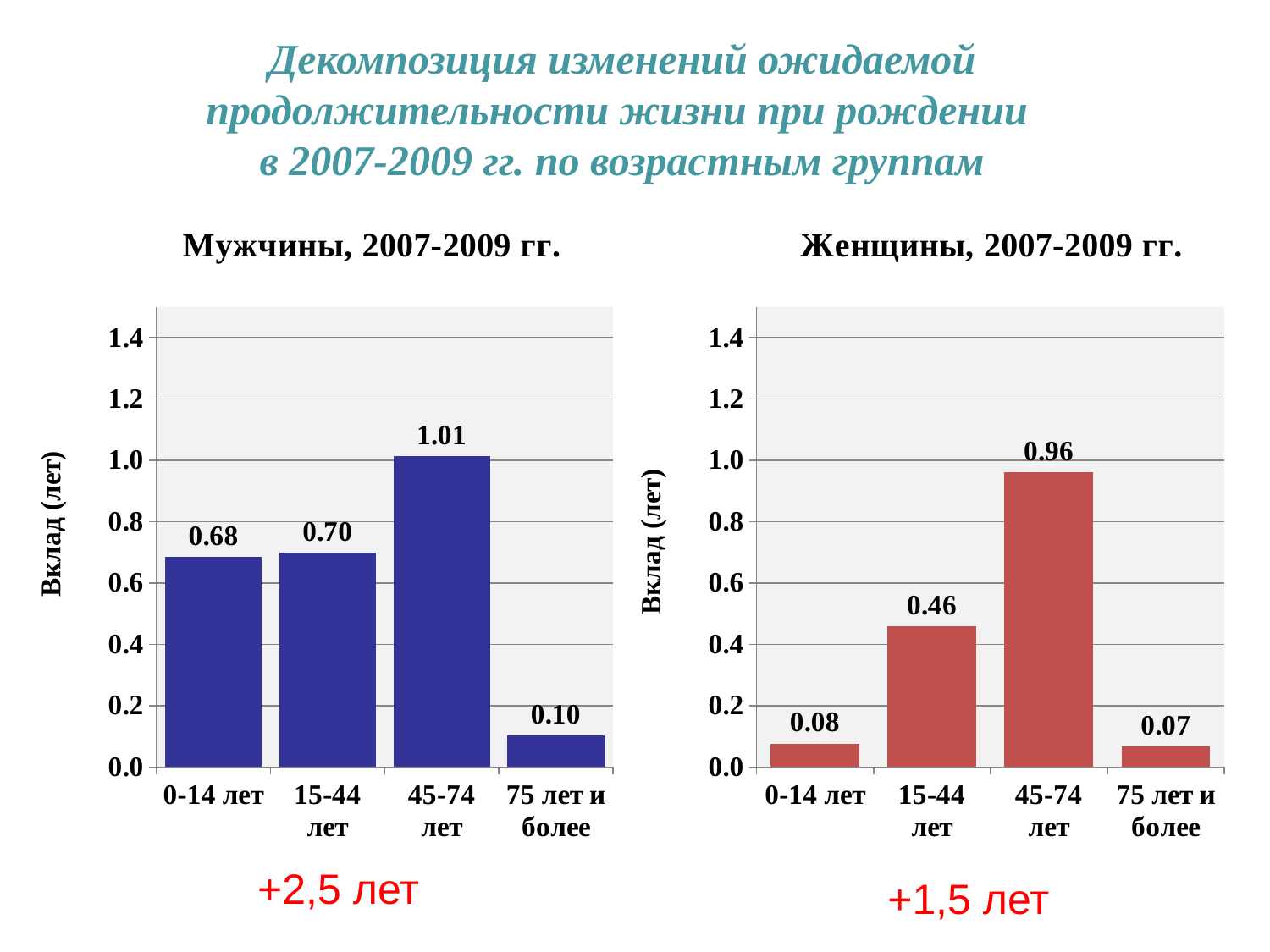
How many age groups are shown in the chart titled "Женщины, 2007-2009 гг."? 4 In the chart titled "Мужчины, 2007-2009 гг.", what is the value for 45-74 лет? 1.01 In the chart titled "Мужчины, 2007-2009 гг.", what is the value for 0-14 лет? 0.68 In the chart titled "Женщины, 2007-2009 гг.", what is the difference between the values for 45-74 лет and 15-44 лет? 0.50 What kind of chart is the chart titled "Мужчины, 2007-2009 гг."? bar chart In the chart titled "Женщины, 2007-2009 гг.", what is the value for 15-44 лет? 0.46 What is the y-axis label of the chart titled "Женщины, 2007-2009 гг."? Вклад (лет) In the chart titled "Женщины, 2007-2009 гг.", which is larger, the value for 0-14 лет or the value for 15-44 лет? 15-44 лет In the chart titled "Мужчины, 2007-2009 гг.", what is the difference between the values for 45-74 лет and 0-14 лет? 0.33 In the chart titled "Мужчины, 2007-2009 гг.", which age group has the lowest value? 75 лет и более In the chart titled "Мужчины, 2007-2009 гг.", is the value for 45-74 лет greater or less than 1.0? greater In the chart titled "Женщины, 2007-2009 гг.", which age group has the highest value? 45-74 лет